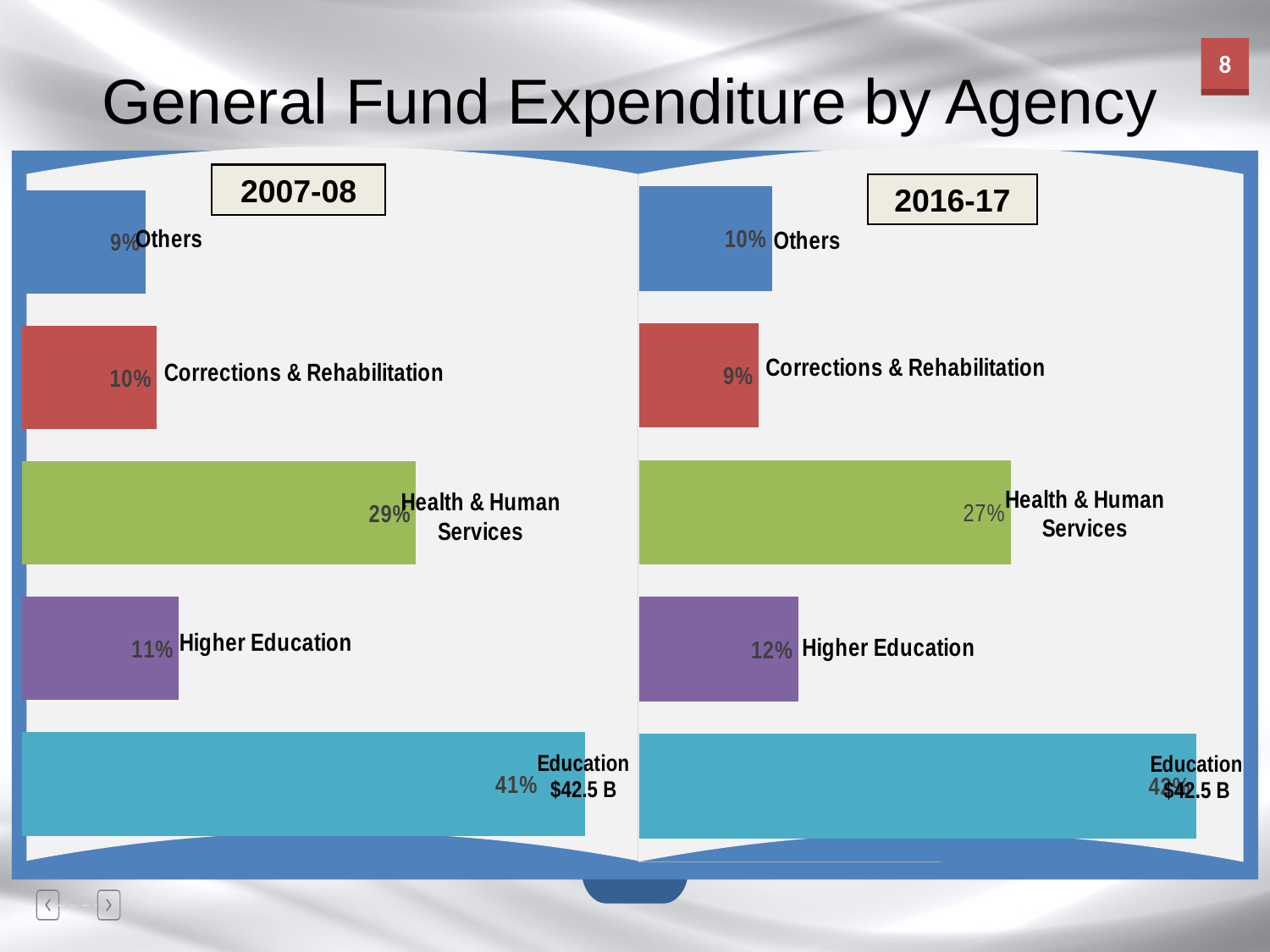
In the 2016-17 chart, which agency has the smallest share? Corrections & Rehabilitation In the 2007-08 chart, what percentage is shown for Education? 41% In the 2007-08 chart, which agency has the smallest share? Others In the 2016-17 chart, which agency has the largest share? Education In the 2007-08 chart, what percentage is shown for Health & Human Services? 29% Which is larger: the Others share in the 2007-08 chart or the Others share in the 2016-17 chart? 2016-17 What is the difference between the Health & Human Services share in the 2007-08 chart and in the 2016-17 chart? 2% What type of chart is used for the 2016-17 data? Bar chart In the 2016-17 chart, what percentage is shown for Corrections & Rehabilitation? 9% How many agency categories are shown in the 2007-08 chart? 5 In the 2007-08 chart, which agency has the largest share? Education In the 2016-17 chart, what percentage is shown for Higher Education? 12%